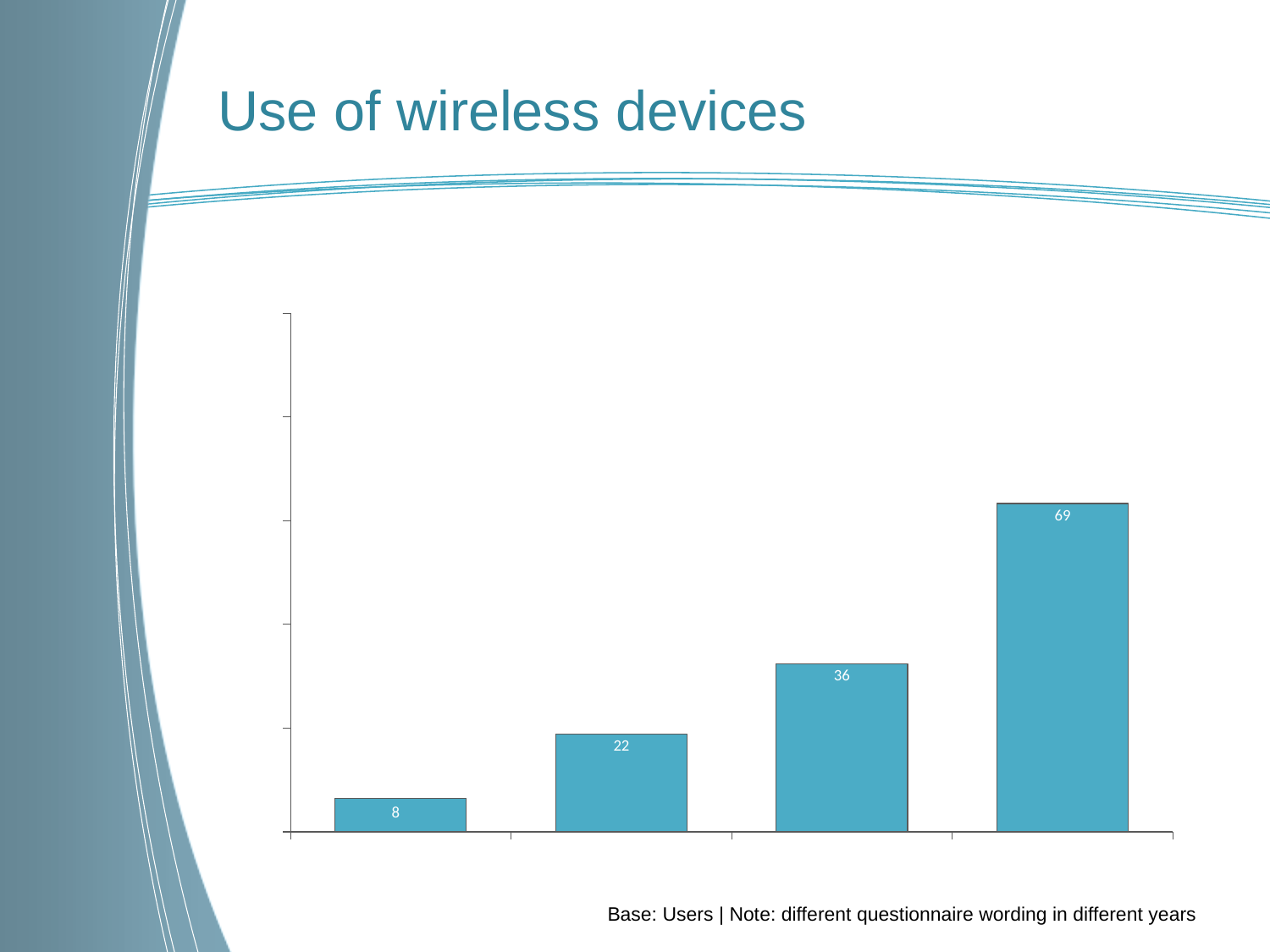
What is the highest value shown in the chart? 69 What is the lowest value shown in the chart? 8 How many bars are plotted in the chart? 4 What is the value of the third bar from the left? 36 What is the difference between the rightmost bar and the leftmost bar? 61 What is the value of the second bar from the left? 22 What is the value of the first (leftmost) bar? 8 Which is larger, the second bar or the third bar? the third bar What is the value of the rightmost bar? 69 Do the bar values rise or fall from left to right? rise What kind of chart is shown on the slide? bar chart What is the title of the slide containing the chart? Use of wireless devices